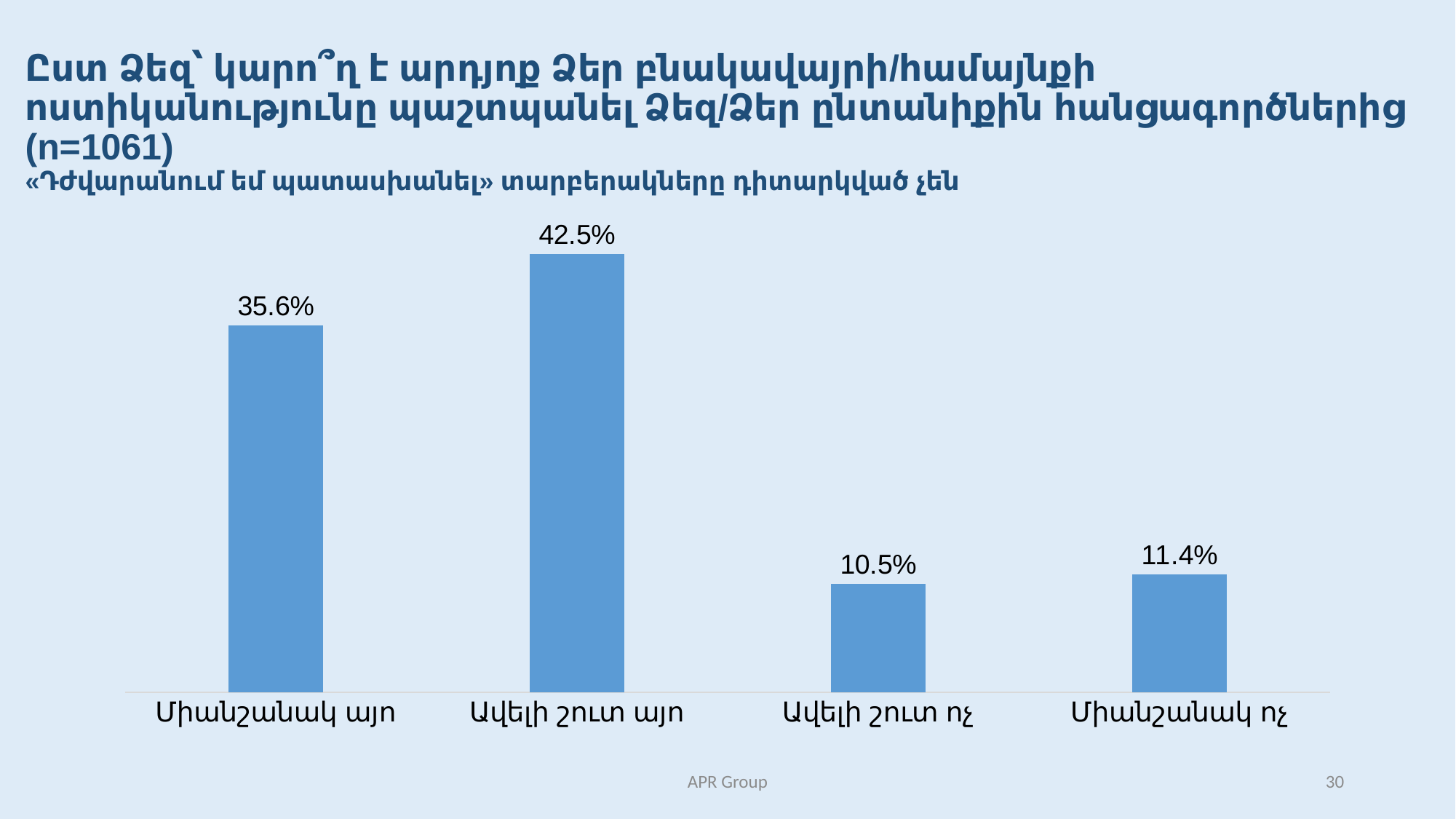
What is the value for Ավելի շուտ այո? 42.5% Which category has the highest value? Ավելի շուտ այո What is the value for Ավելի շուտ ոչ? 10.5% What is the value for Միանշանակ ոչ? 11.4% What is the difference between the values for Միանշանակ ոչ and Ավելի շուտ ոչ? 0.9% Which is larger, the value for Միանշանակ այո or the value for Միանշանակ ոչ? Միանշանակ այո What is the value for Միանշանակ այո? 35.6% How many categories are shown in the chart? 4 Which category has the lowest value? Ավելի շուտ ոչ What kind of chart is shown on the slide? Bar chart What is the difference between the values for Ավելի շուտ այո and Միանշանակ այո? 6.9% What is the sample size (n) stated in the chart title? 1061